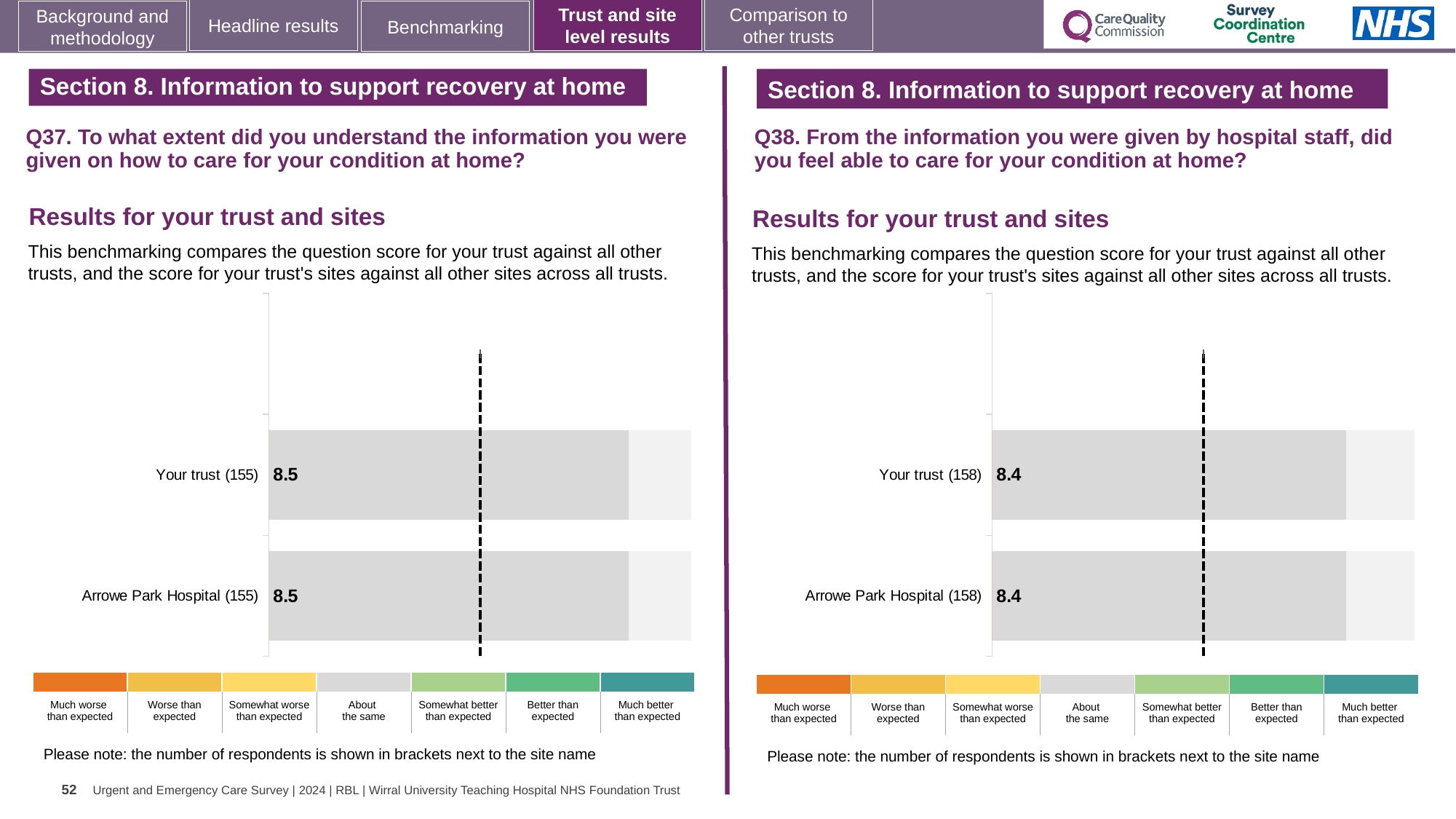
In the Q37 chart on the left, what is the score for Arrowe Park Hospital? 8.5 In the Q38 chart on the right, what is the score for Your trust? 8.4 In the Q37 chart on the left, what is the score for Your trust? 8.5 In the Q37 chart on the left, how many respondents are shown in brackets for Your trust? 155 How many categories does the colour key below the Q37 chart on the left list? 7 How many bars are plotted in the Q38 chart on the right? 2 What kind of chart is used for the Q38 results on the right? Bar chart In the Q38 chart on the right, how many respondents are shown in brackets for Arrowe Park Hospital? 158 In the colour key below the Q38 chart on the right, which category is shown in orange? Much worse than expected How many bars are plotted in the Q37 chart on the left? 2 In the Q38 chart on the right, what is the score for Arrowe Park Hospital? 8.4 What is the difference between the Your trust score in the Q37 chart on the left and the Your trust score in the Q38 chart on the right? 0.1